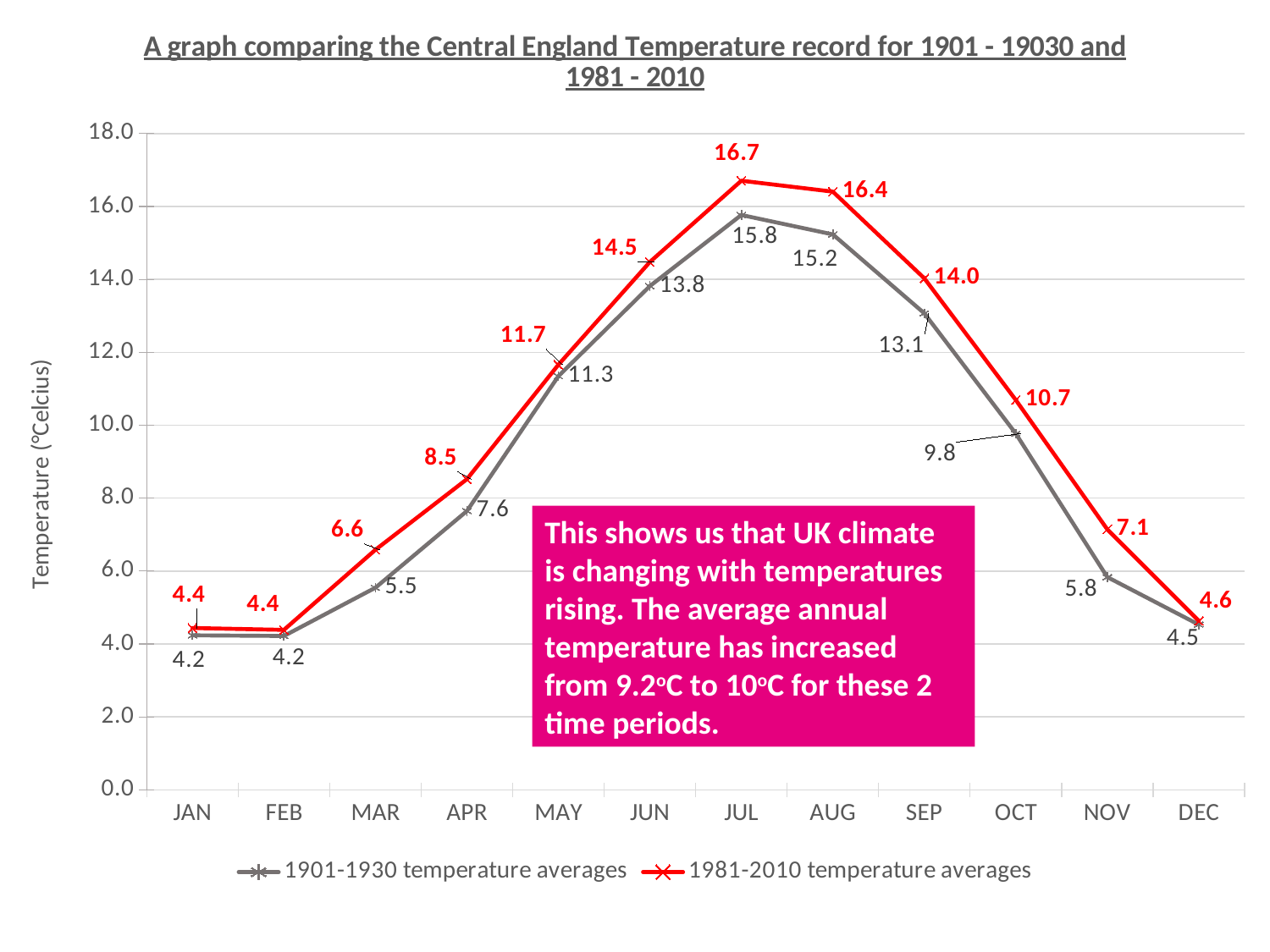
What colour is the line for the 1981-2010 temperature averages? Red Which month has the lowest 1981-2010 temperature average? JAN and FEB (both 4.4) What is the 1981-2010 temperature average for APR? 8.5 What kind of chart is shown on the slide? Line chart Which month has the highest 1901-1930 temperature average? JUL How many months are plotted on the x axis? 12 Do the 1901-1930 temperature averages rise or fall from JAN to JUL? Rise What is the difference between the 1981-2010 and 1901-1930 temperature averages for SEP? 0.9 Which is larger, the 1981-2010 temperature average for AUG or the 1901-1930 temperature average for AUG? 1981-2010 temperature average for AUG How many series does the legend list? 2 What is the 1901-1930 temperature average for OCT? 9.8 What is the 1981-2010 temperature average for JUL? 16.7